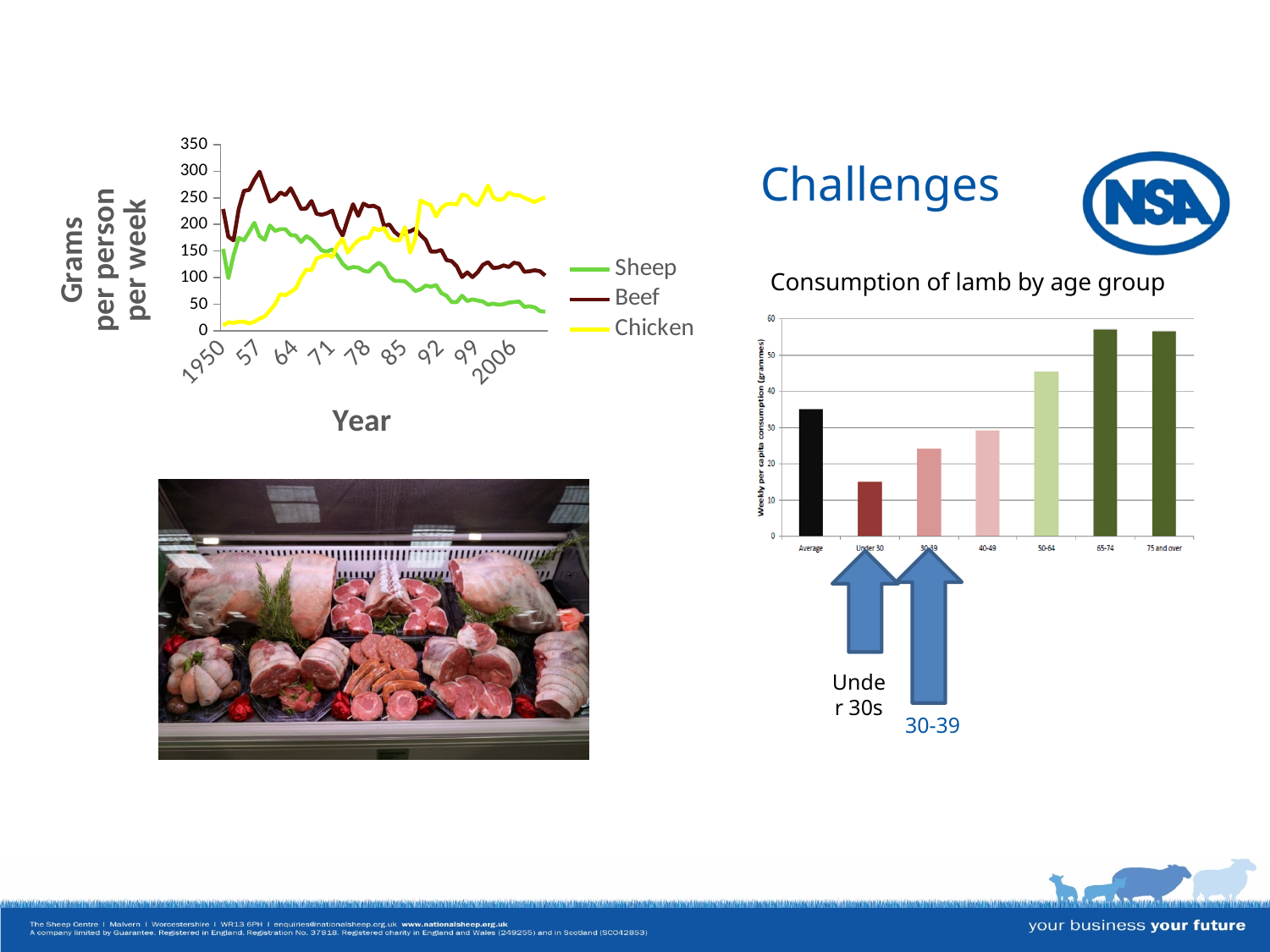
In the left-hand line chart, which series rises overall from 1950 to 2006? Chicken In the left-hand line chart, does the Sheep series rise or fall between 1964 and 2006? fall In the 'Consumption of lamb by age group' chart, is the value for Under 30 greater or less than 20? less What kind of chart is the chart on the left showing grams per person per week by year? line chart How many bars are shown in the 'Consumption of lamb by age group' chart? 7 In the 'Consumption of lamb by age group' chart, which is larger, the value for 50-64 or the value for 40-49? 50-64 How many series does the legend of the left-hand line chart list? 3 What kind of chart is 'Consumption of lamb by age group'? bar chart In the left-hand line chart, which series has the highest value in 1950? Beef In the 'Consumption of lamb by age group' chart, which age group has the lowest consumption? Under 30 In the left-hand line chart, is the Chicken value in 1950 greater or less than 50? less In the left-hand line chart, is the Beef value in 2006 greater or less than 150? less